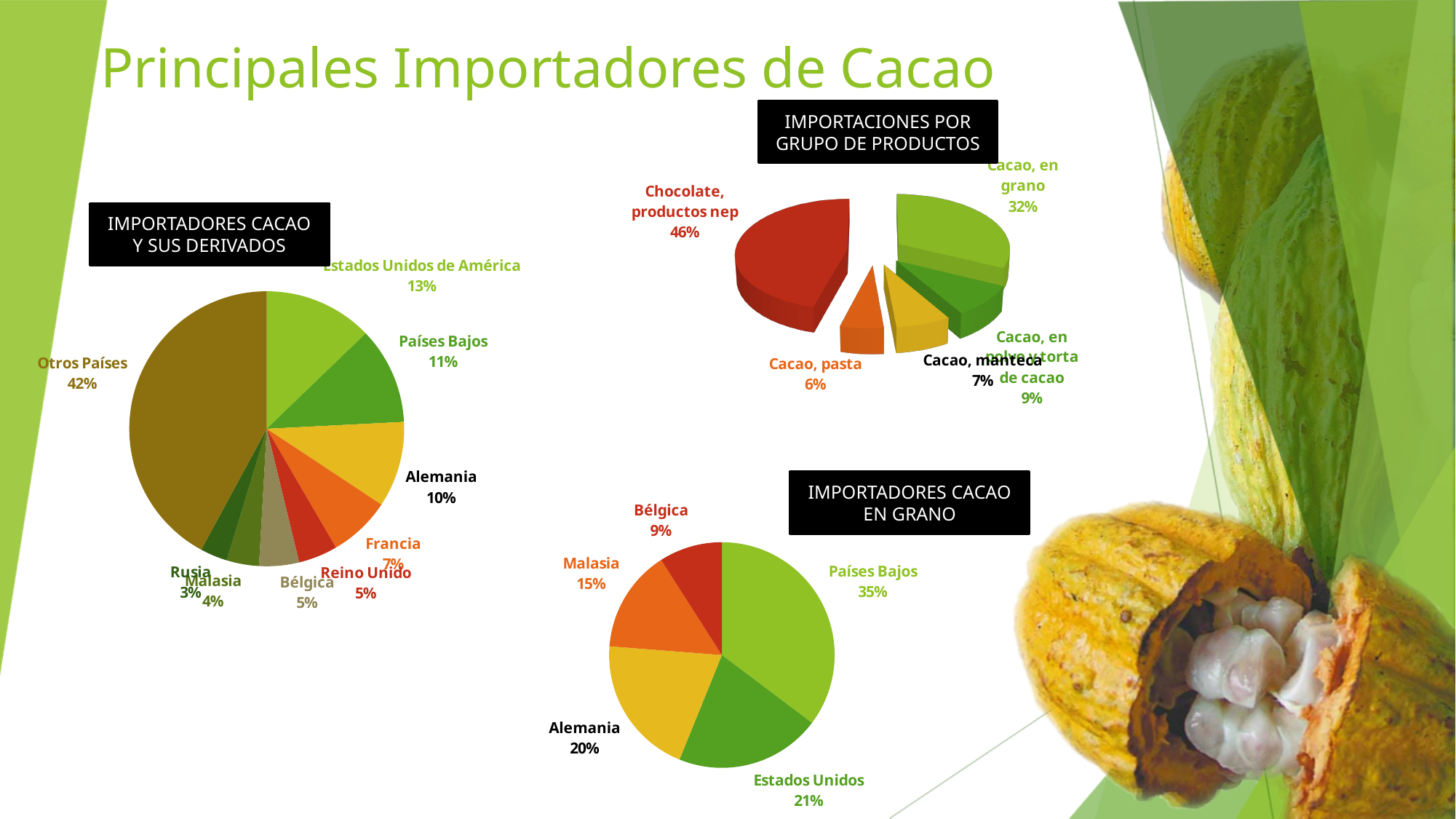
In the 'IMPORTADORES CACAO Y SUS DERIVADOS' chart, which category has the smallest share? Rusia In the 'IMPORTACIONES POR GRUPO DE PRODUCTOS' chart, what is the difference between Cacao, en grano and Cacao, pasta? 26% In the 'IMPORTADORES CACAO Y SUS DERIVADOS' chart, what share does Otros Países have? 42% In the 'IMPORTADORES CACAO EN GRANO' chart, what is the difference between Estados Unidos and Malasia? 6% In the 'IMPORTADORES CACAO Y SUS DERIVADOS' chart, how many slices does the pie have? 9 In the 'IMPORTADORES CACAO EN GRANO' chart, which country has the smallest share? Bélgica In the 'IMPORTADORES CACAO EN GRANO' chart, what share does Países Bajos have? 35% In the 'IMPORTACIONES POR GRUPO DE PRODUCTOS' chart, what share does Chocolate, productos nep have? 46% What kind of chart is the 'IMPORTACIONES POR GRUPO DE PRODUCTOS' chart? Pie chart In the 'IMPORTADORES CACAO Y SUS DERIVADOS' chart, which named country (excluding Otros Países) has the largest share? Estados Unidos de América In the 'IMPORTACIONES POR GRUPO DE PRODUCTOS' chart, which is larger, Cacao, manteca or Cacao, pasta? Cacao, manteca In the 'IMPORTADORES CACAO Y SUS DERIVADOS' chart, what is the value for Alemania? 10%